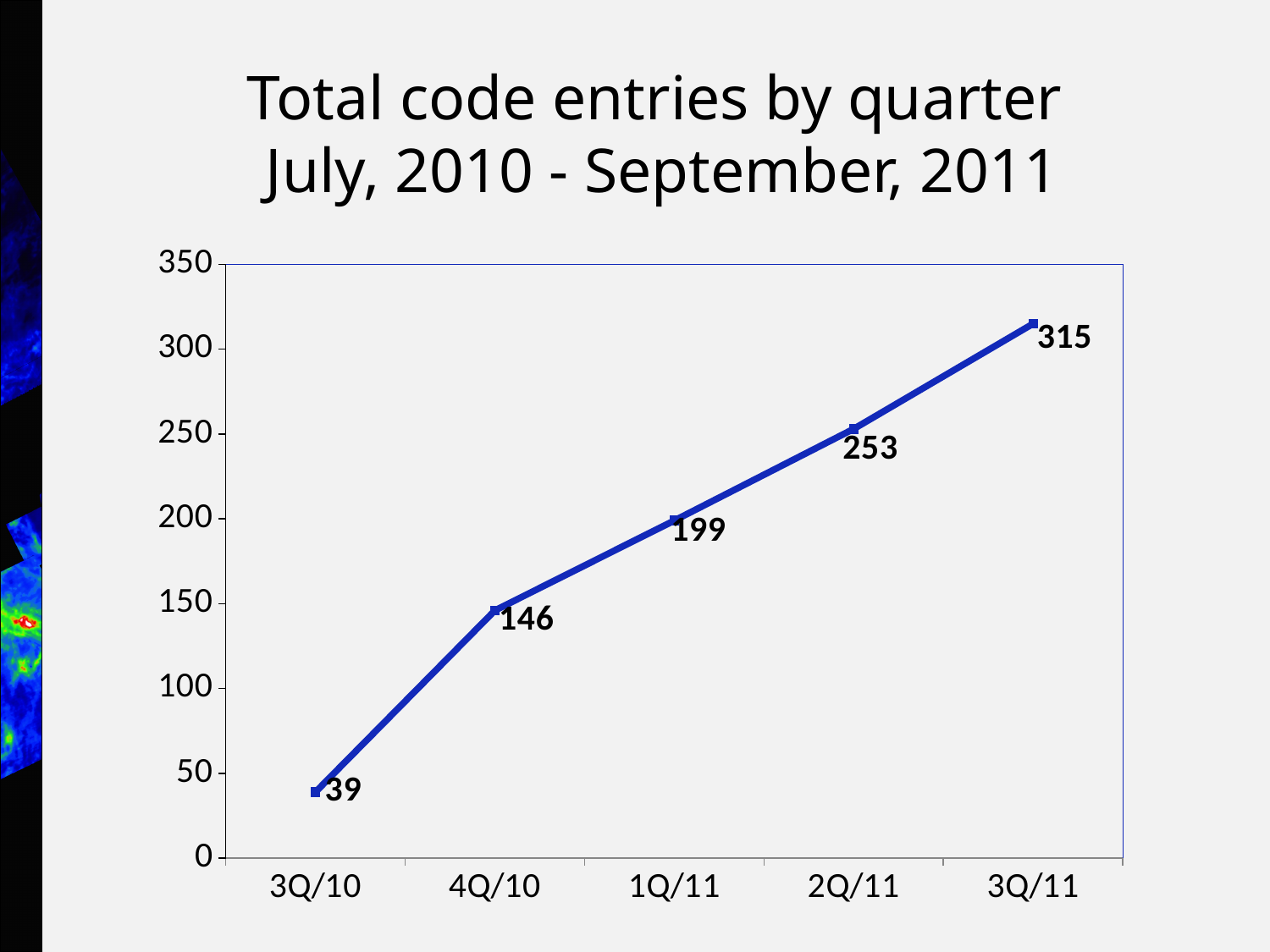
What is the difference between the values for 3Q/11 and 2Q/11? 62 Which is larger, the value for 2Q/11 or the value for 1Q/11? 2Q/11 Which quarter has the lowest value? 3Q/10 Which quarter has the highest value? 3Q/11 What is the value for 1Q/11? 199 What is the difference between the values for 4Q/10 and 3Q/10? 107 What kind of chart is shown on the slide? line chart How many quarters are plotted on the chart? 5 What is the value for 3Q/10? 39 Do the values rise or fall from 3Q/10 to 3Q/11? rise What is the value for 3Q/11? 315 Is the value for 4Q/10 greater or less than 150? less